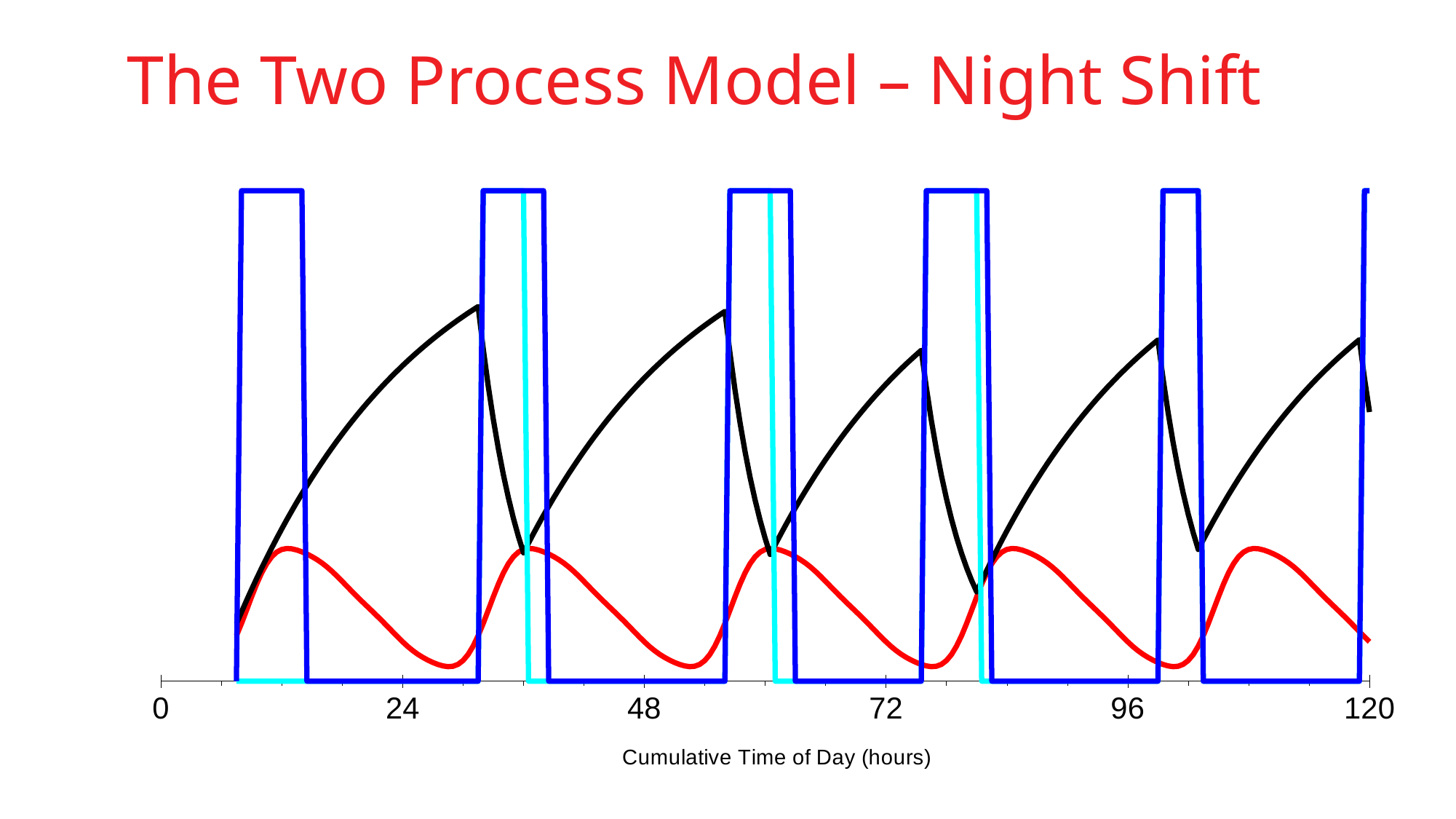
What is the lowest value labelled on the x axis? 0 What is the highest value labelled on the x axis? 120 What is the spacing between consecutive tick labels on the x axis? 24 How many tick labels are printed on the x axis? 6 Between 32 and 36 hours, does the black line rise or fall? fall Between 24 and 30 hours, does the black line rise or fall? rise Between 12 and 24 hours, does the red line rise or fall? fall What kind of chart is shown on the slide? line chart What is the title of the slide's chart? The Two Process Model – Night Shift What is the label of the x axis? Cumulative Time of Day (hours)